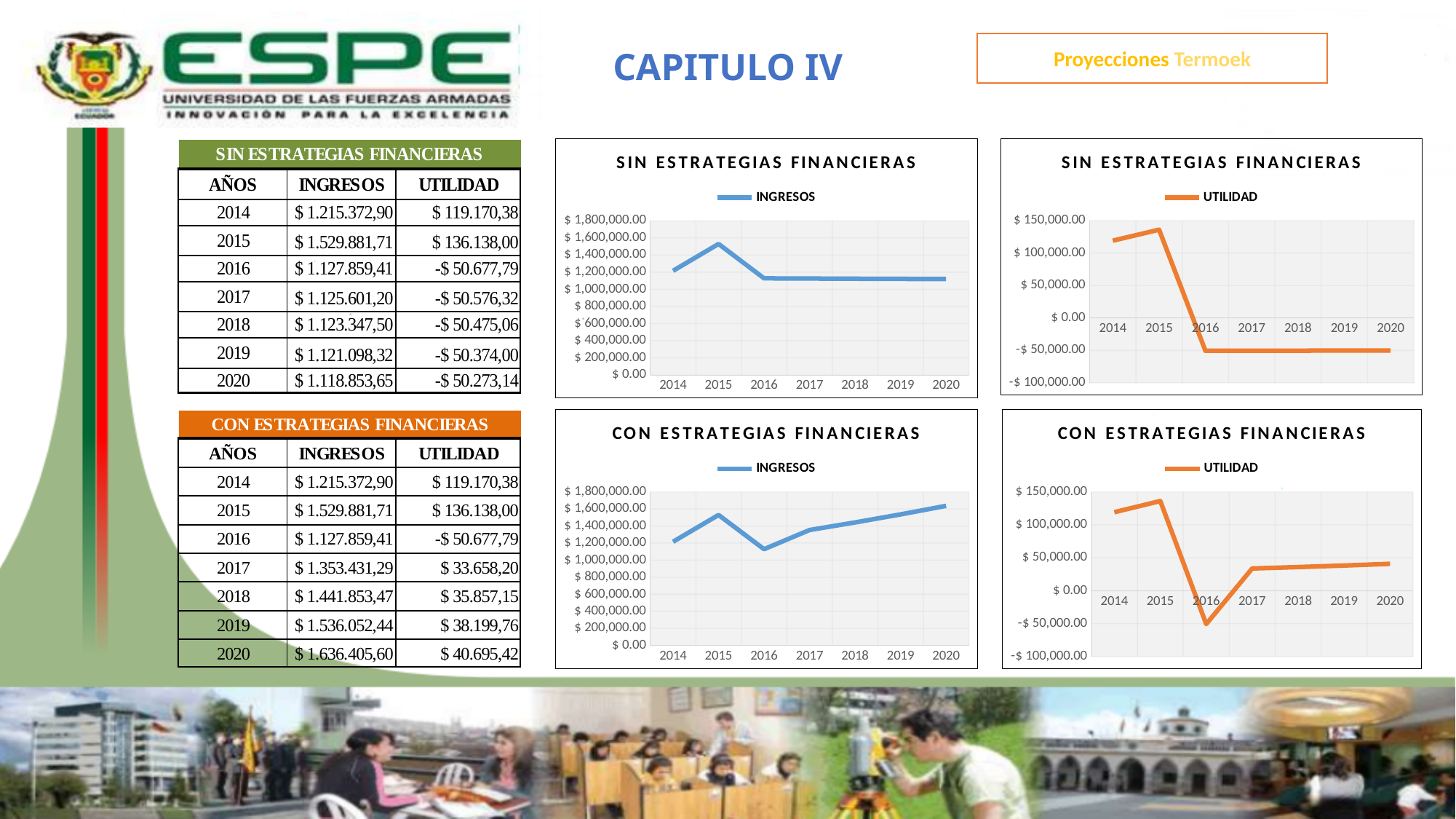
In the bottom-left CON ESTRATEGIAS FINANCIERAS (INGRESOS) chart, do the values rise or fall from 2016 to 2020? Rise How many years are plotted along the x axis of the bottom-right CON ESTRATEGIAS FINANCIERAS (UTILIDAD) chart? 7 In the top-right SIN ESTRATEGIAS FINANCIERAS (UTILIDAD) chart, is the value for 2015 or 2016 larger? 2015 In the top-left SIN ESTRATEGIAS FINANCIERAS (INGRESOS) chart, which year has the highest value? 2015 How many series does the legend of the top-right SIN ESTRATEGIAS FINANCIERAS (UTILIDAD) chart list? 1 In the bottom-right CON ESTRATEGIAS FINANCIERAS (UTILIDAD) chart, which year has the lowest value? 2016 In the bottom-left CON ESTRATEGIAS FINANCIERAS (INGRESOS) chart, which year has the lowest value? 2016 In the bottom-right CON ESTRATEGIAS FINANCIERAS (UTILIDAD) chart, is the value for 2017 greater or less than $ 50,000.00? less What kind of chart is the top-left chart titled SIN ESTRATEGIAS FINANCIERAS (INGRESOS)? Line chart What colour is the UTILIDAD line in the top-right SIN ESTRATEGIAS FINANCIERAS chart? Orange According to the CON ESTRATEGIAS FINANCIERAS table, what is the UTILIDAD value for 2020 plotted in the bottom-right chart? $ 40.695,42 In the top-right SIN ESTRATEGIAS FINANCIERAS (UTILIDAD) chart, is the value for 2014 greater or less than $ 100,000.00? greater